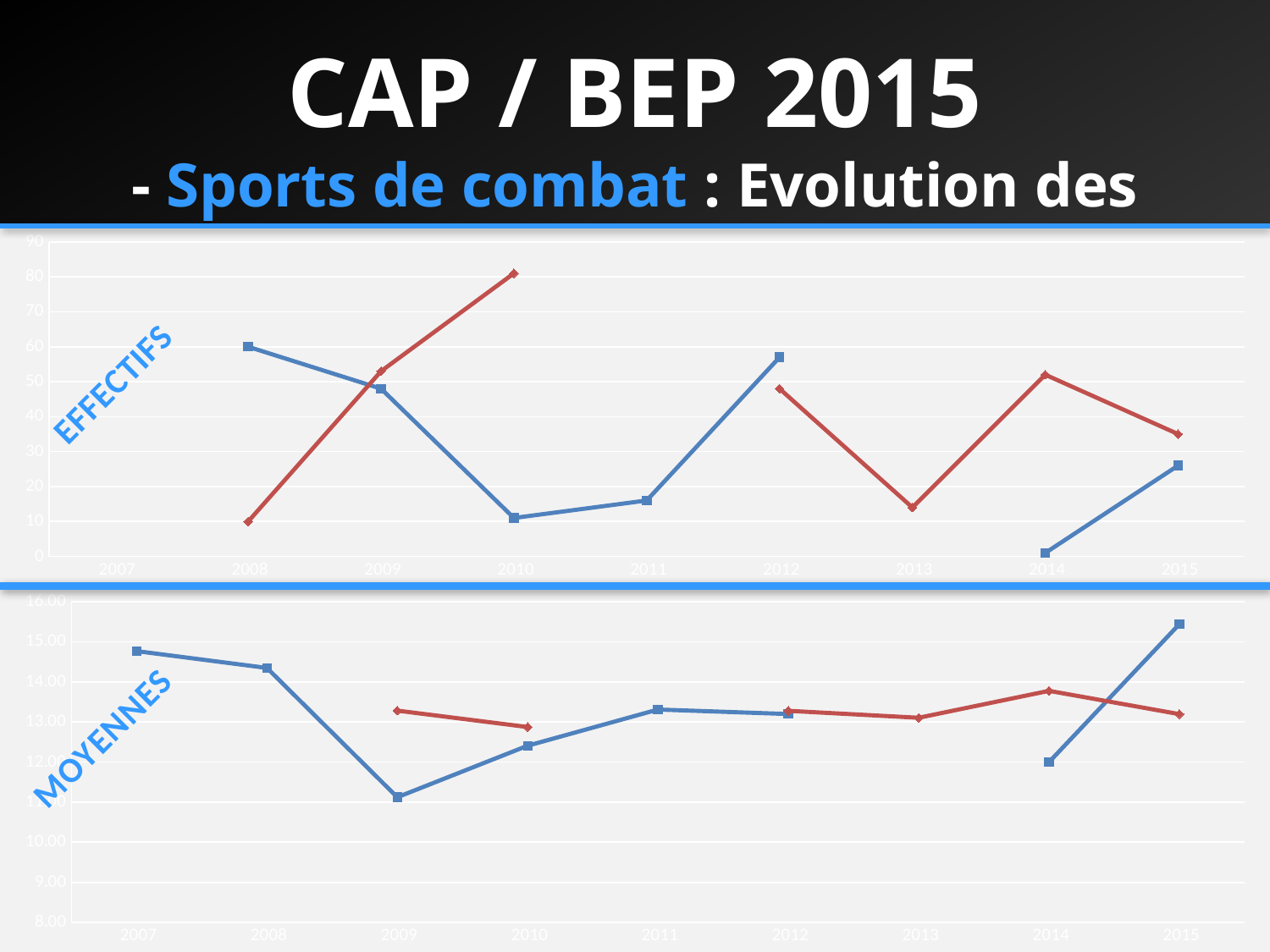
In the bottom chart (MOYENNES), is the value of the blue line in 2009 greater or less than 12.00? less In the top chart (EFFECTIFS), in which year does the blue line reach its lowest value? 2014 In the top chart (EFFECTIFS), is the value of the blue line in 2010 greater or less than 20? less What label is written along the left side of the bottom chart? MOYENNES How many years are shown on the x axis of the bottom chart labelled MOYENNES? 9 In the bottom chart (MOYENNES), which line has the higher value in 2014, the blue line or the red line? the red line In the top chart (EFFECTIFS), in which year does the red line reach its highest value? 2010 In the top chart (EFFECTIFS), does the blue line rise or fall between 2008 and 2010? fall In the bottom chart (MOYENNES), in which year does the blue line reach its highest value? 2015 In the top chart (EFFECTIFS), which line has the higher value in 2008, the blue line or the red line? the blue line In the top chart (EFFECTIFS), is the value of the red line in 2010 greater or less than 70? greater What kind of chart is the top chart labelled EFFECTIFS? line chart